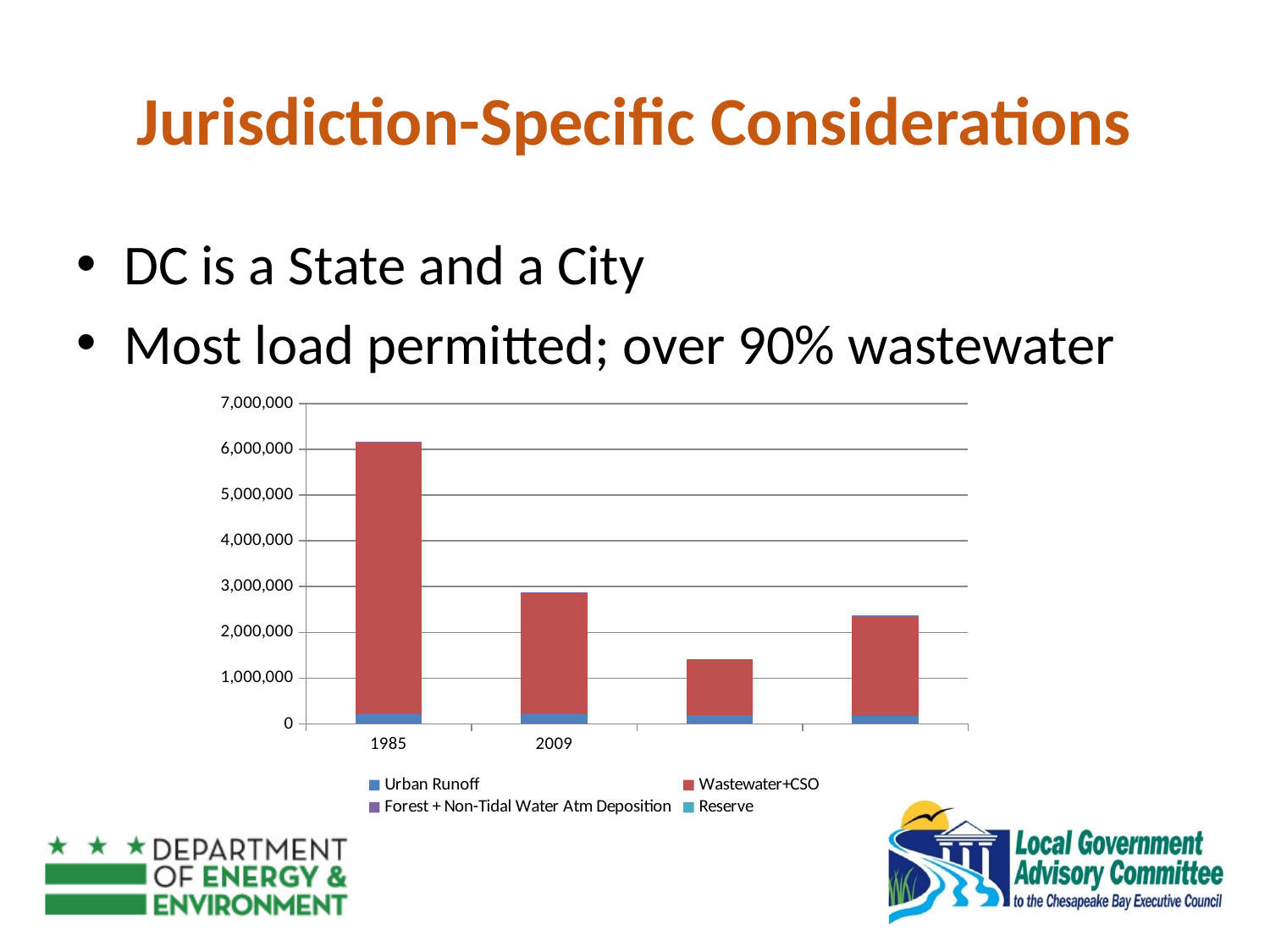
Is the total value of the 2009 bar greater or less than 2,000,000? greater How many series does the chart legend list? 4 What is the highest value shown on the vertical axis? 7,000,000 How many bars are plotted in the chart? 4 Which bar is taller, 1985 or 2009? 1985 What kind of chart is shown on the slide? stacked bar chart Of the two labeled categories, 1985 and 2009, which has the lower total? 2009 Is the total value of the 2009 bar greater or less than 4,000,000? less Is the total value of the 1985 bar greater or less than 5,000,000? greater Which series makes up the largest portion of each bar? Wastewater+CSO Do the bar totals rise or fall from 1985 to 2009? fall